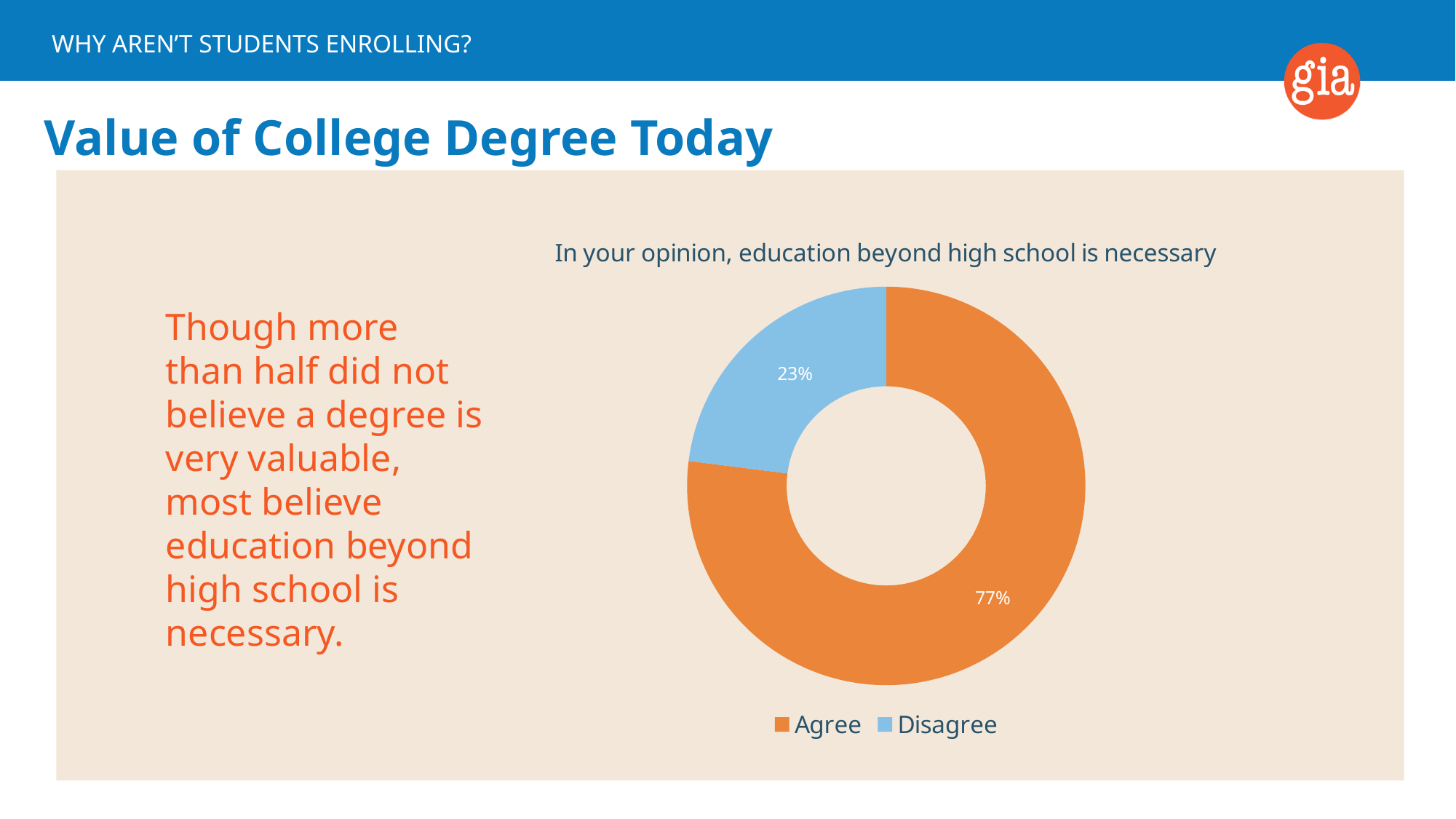
Which response has the smallest share of the chart? Disagree What percentage of respondents disagree that education beyond high school is necessary? 23% What share of the chart does the Agree slice represent? 77% What is the title of the chart? In your opinion, education beyond high school is necessary Which response has the largest share of the chart? Agree How many categories does the chart show? 2 Which is larger, the Agree share or the Disagree share? Agree What kind of chart is shown on the slide? Doughnut chart What is the difference in percentage points between Agree and Disagree? 54 What percentage of respondents agree that education beyond high school is necessary? 77% What colour represents Disagree in the chart? Light blue